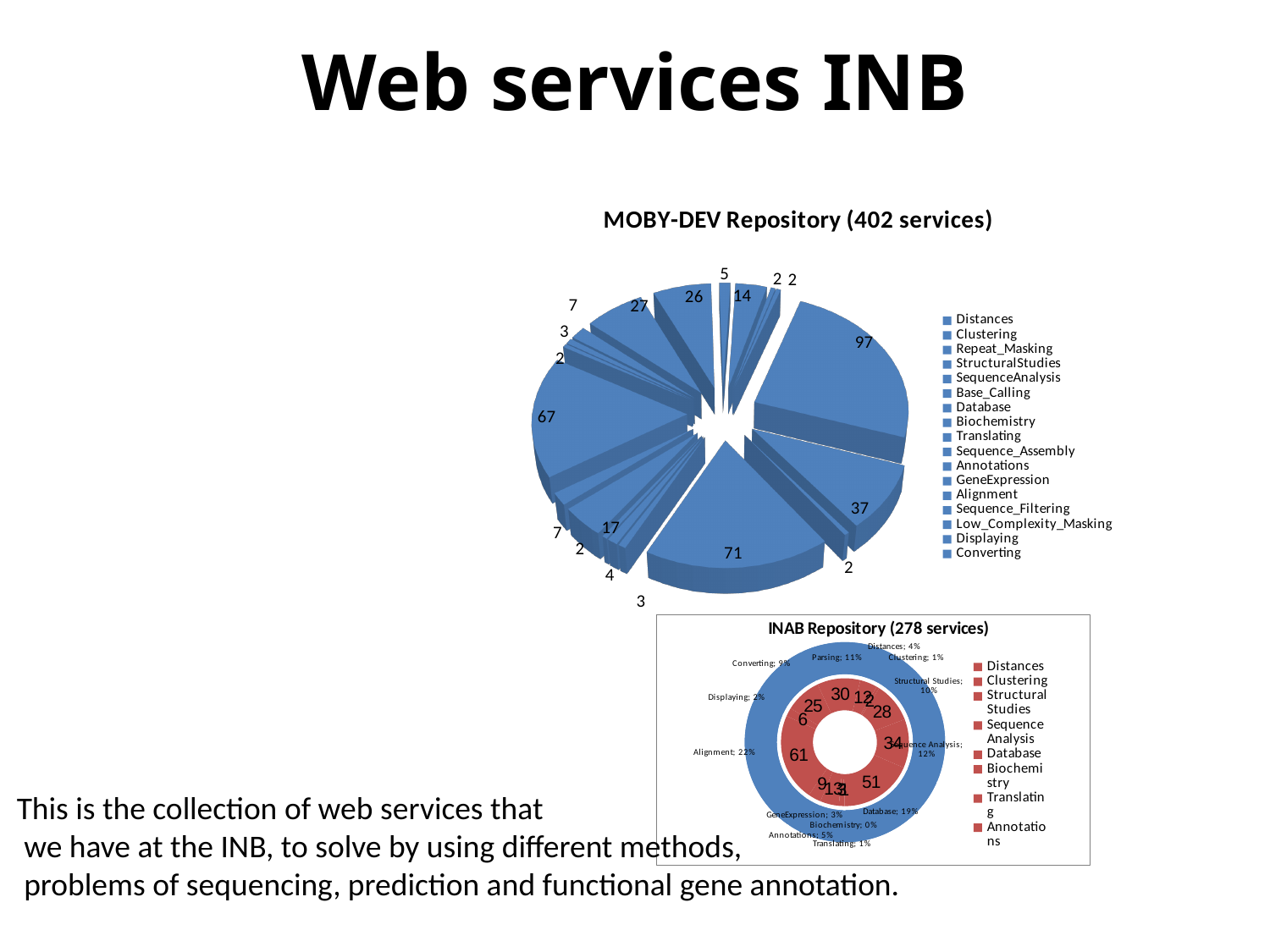
In the INAB Repository chart, what share is shown for Sequence Analysis? 12% How many categories does the legend of the MOBY-DEV Repository chart list? 17 In the INAB Repository chart, what share is shown for Database? 19% According to its title, how many services does the INAB Repository chart cover? 278 In the INAB Repository chart, what is the difference between the shares of Alignment and Database? 3% In the INAB Repository chart, which category has the largest share? Alignment What kind of chart is the MOBY-DEV Repository chart? pie chart In the INAB Repository chart, which has the larger share, Parsing or Converting? Parsing What is the title of the chart at the top of the slide? MOBY-DEV Repository (402 services) In the INAB Repository chart, what share is shown for Alignment? 22% In the MOBY-DEV Repository chart, what is the largest value labelled on any slice? 97